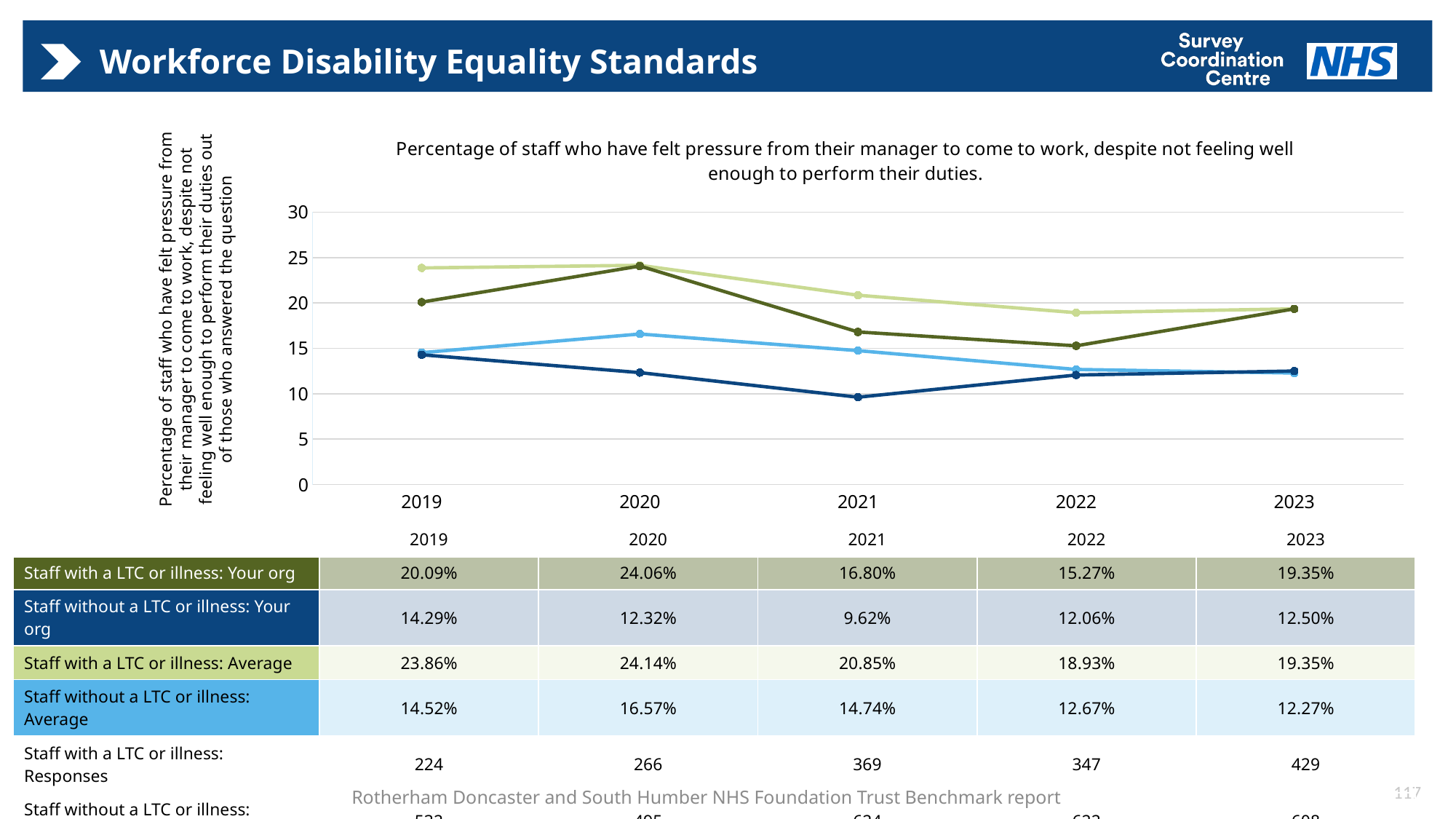
In which year is the value for Staff without a LTC or illness: Your org lowest? 2021 What is the value for Staff without a LTC or illness: Average in 2020? 16.57% What is the difference between the 2020 and 2022 values for Staff with a LTC or illness: Your org? 8.79 percentage points Is the 2021 value for Staff with a LTC or illness: Your org greater or less than 15? greater Does the value for Staff with a LTC or illness: Average rise or fall from 2020 to 2022? fall What kind of chart is shown on the slide? line chart What is the value for Staff with a LTC or illness: Your org in 2020? 24.06% What is the value for Staff without a LTC or illness: Your org in 2021? 9.62% How many data series are plotted on the chart? 4 In which year is the value for Staff with a LTC or illness: Average highest? 2020 How many years are shown on the x axis of the chart? 5 In 2019, which is larger: Staff with a LTC or illness: Your org or Staff with a LTC or illness: Average? Staff with a LTC or illness: Average